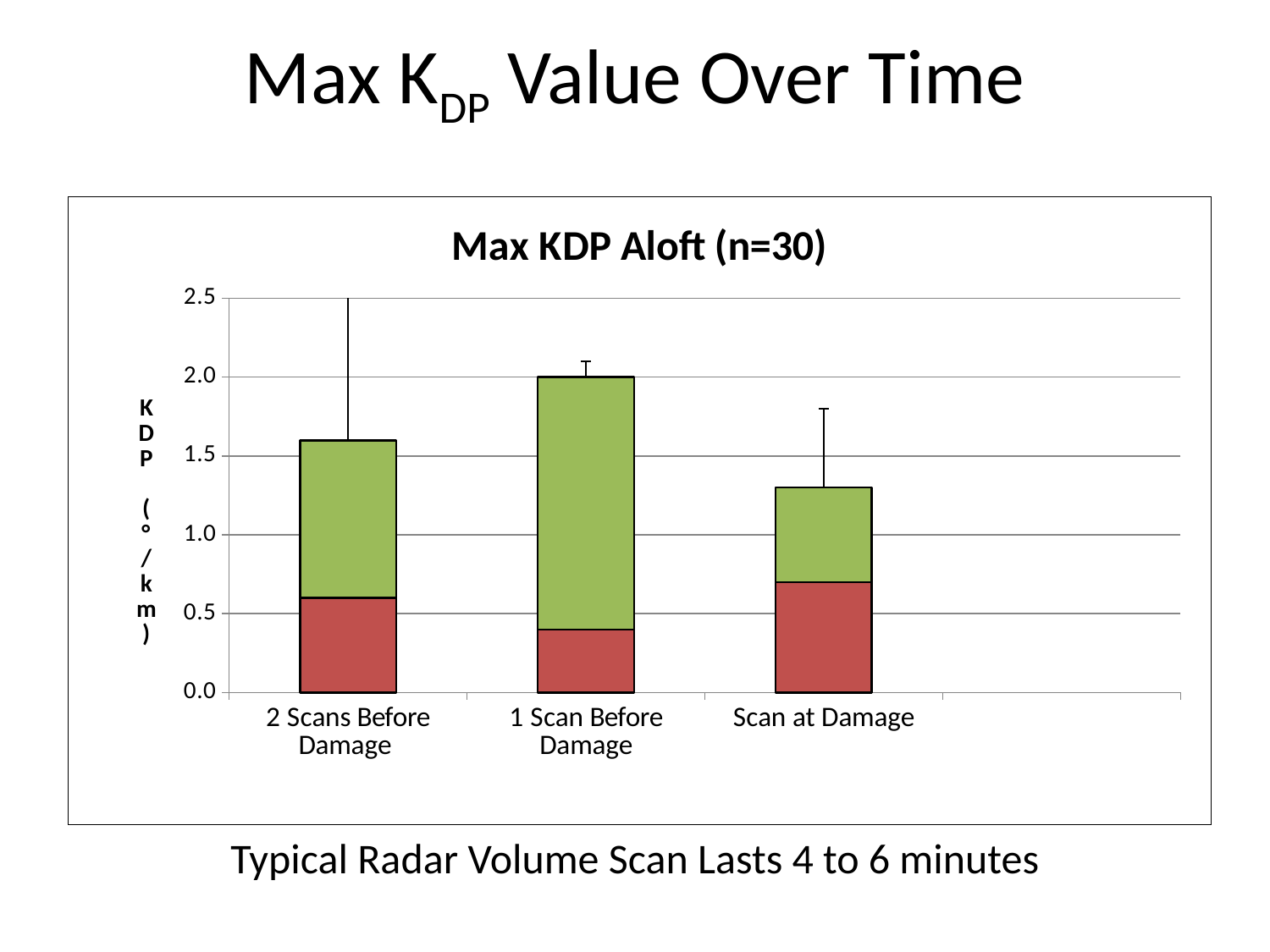
Is the total bar height for 2 Scans Before Damage greater or less than 1.5? greater Which category has the shortest bar in the chart? Scan at Damage Which category has the tallest bar in the chart? 1 Scan Before Damage Is the total bar height for Scan at Damage greater or less than 1.5? less Which bar is taller overall: 2 Scans Before Damage or Scan at Damage? 2 Scans Before Damage What is the total height of the bar for 1 Scan Before Damage? 2.0 What kind of chart is shown on the slide? Stacked bar chart What is the title of the chart? Max KDP Aloft (n=30) Is the red segment for Scan at Damage greater or less than 0.5? greater How many categories are shown on the x axis of the chart? 3 What is the highest value shown on the y axis of the chart? 2.5